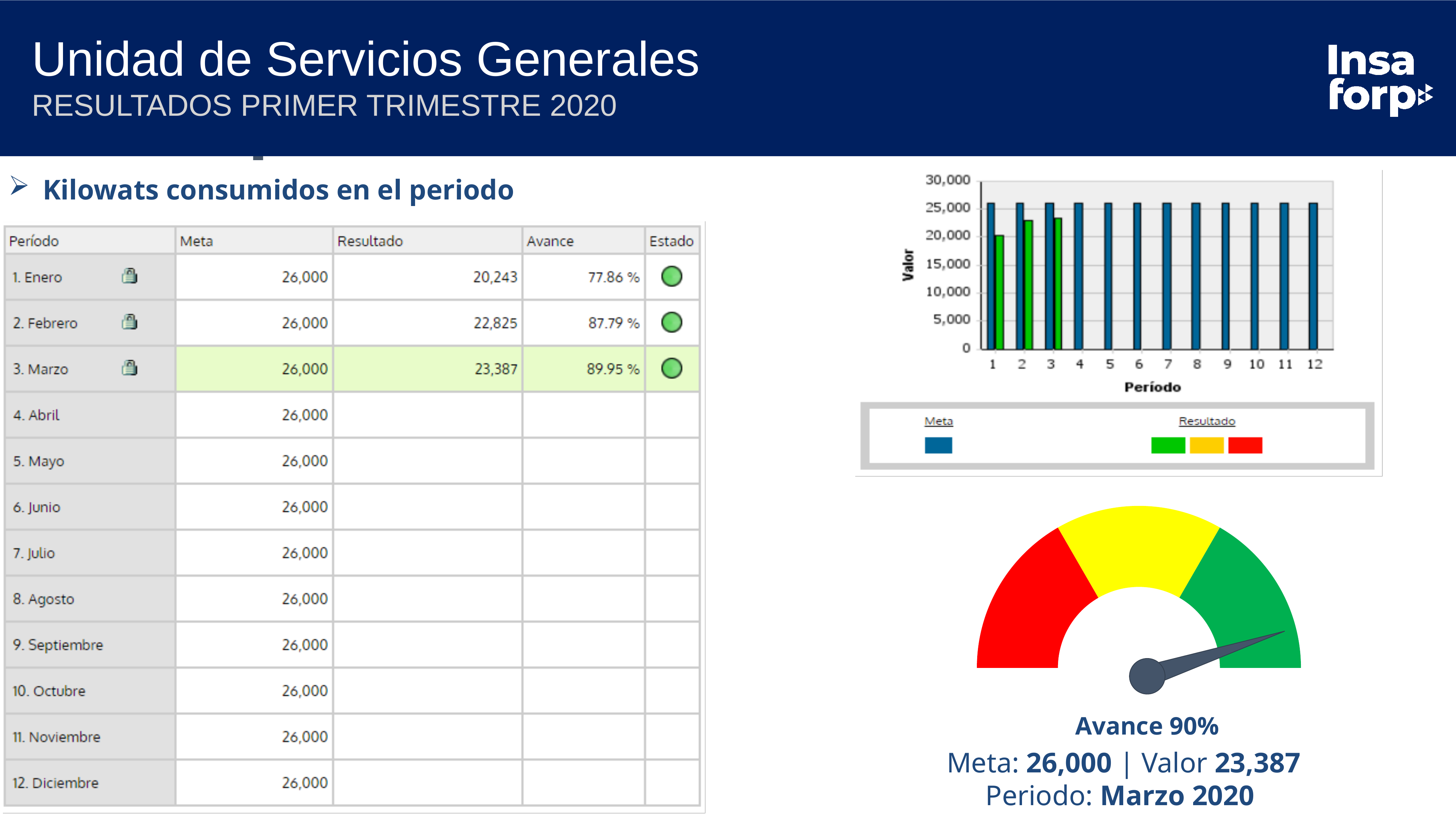
What Valor is shown under the gauge chart for Marzo 2020? 23,387 In the bar chart at the top right, how many series does the legend list? 2 In the bar chart at the top right, which period has the lowest Resultado bar? 1 In the bar chart at the top right, which period has the highest Resultado bar? 3 What kind of chart is the chart at the top right of the slide? bar chart In the bar chart at the top right, how many periods are shown on the x axis? 12 In the bar chart at the top right, which is larger for period 1, Meta or Resultado? Meta In the bar chart at the top right, do the Resultado bars rise or fall from period 1 to period 3? rise In the bar chart at the top right, is the Meta value for period 5 greater or less than 25,000? greater In the bar chart at the top right, how many periods have a Resultado bar plotted? 3 What Avance percentage is shown under the gauge chart? 90% In the bar chart at the top right, is the Resultado value for period 1 greater or less than 25,000? less